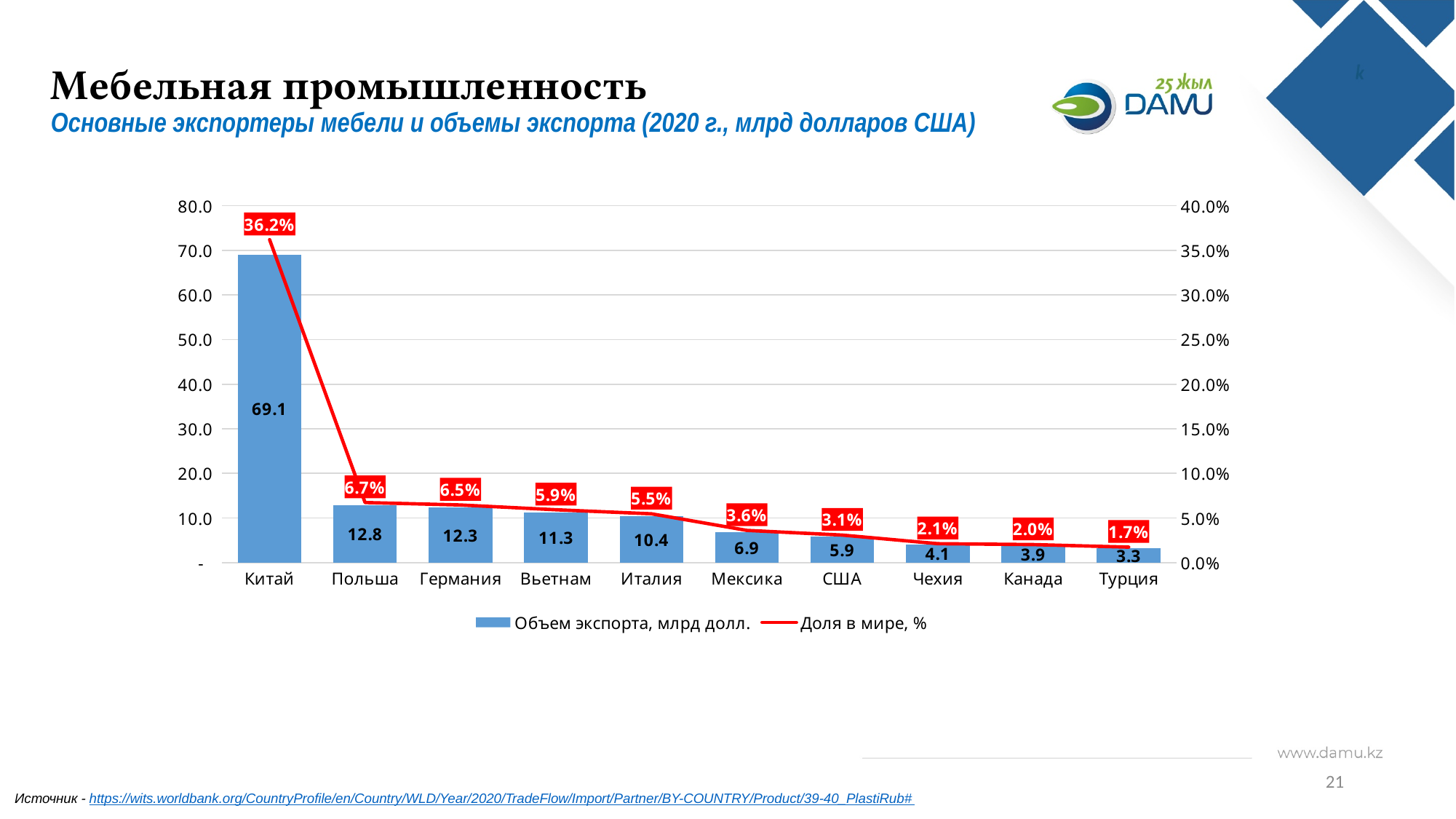
Which country has the highest export volume? Китай How many series does the legend list? 2 What is the world share (Доля в мире, %) for Польша? 6.7% What is the export volume (Объем экспорта, млрд долл.) for Китай? 69.1 What is the export volume for Вьетнам? 11.3 What colour is the line for Доля в мире, %? red What is the world share for Турция? 1.7% Which country has the lowest export volume? Турция Which has a larger export volume, Мексика or США? Мексика What is the difference in export volume between Германия and Италия? 1.9 How many countries are shown on the x axis? 10 Do the export volumes rise or fall from left to right along the x axis? fall